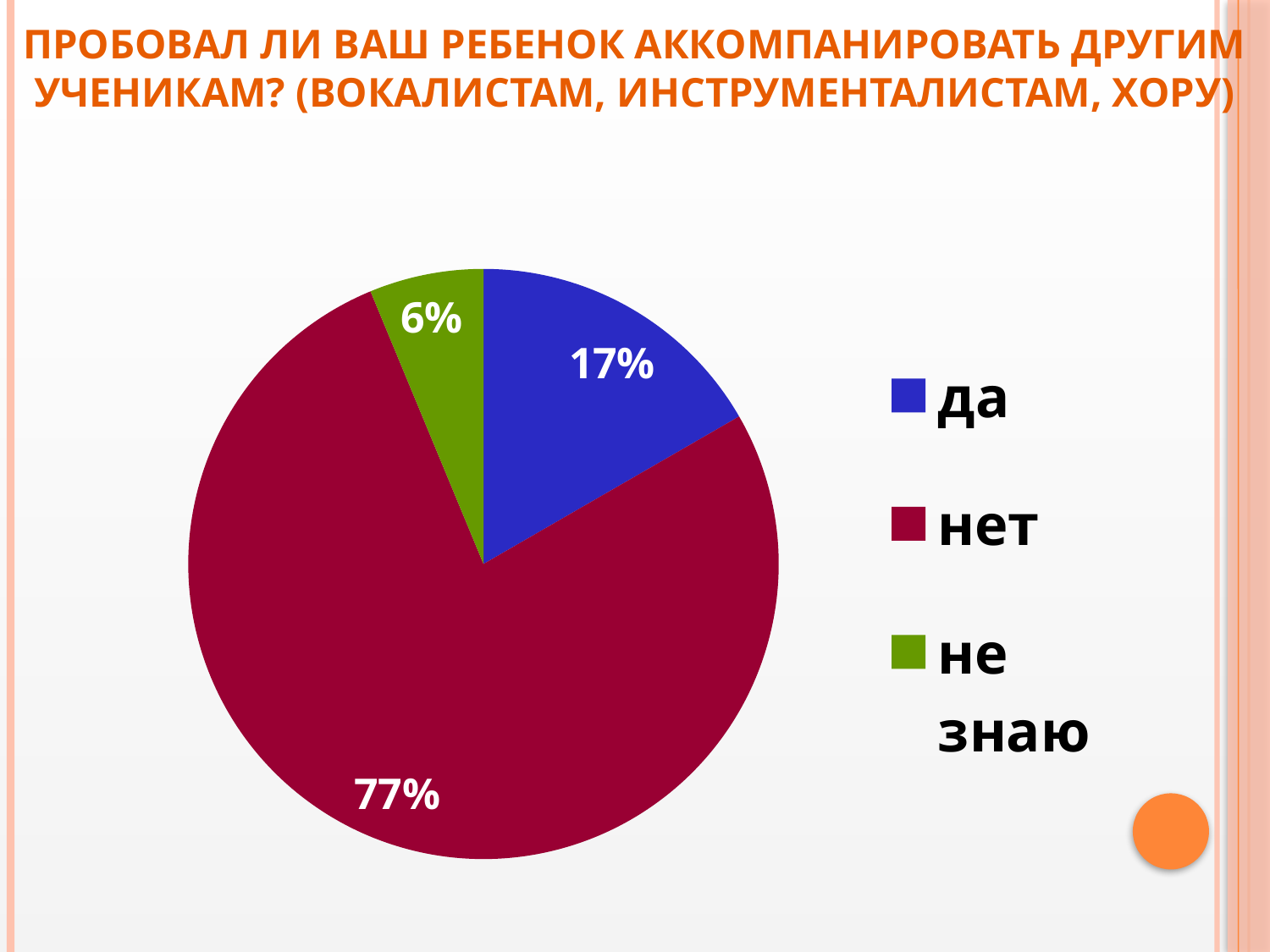
What kind of chart is shown on the slide? pie chart What is the difference in percentage points between the "нет" and "да" slices? 60 What percentage is shown for the "не знаю" slice? 6% Which is larger, the "да" slice or the "не знаю" slice? да Which category has the largest share of the pie? нет What is the difference in percentage points between the "да" and "не знаю" slices? 11 What percentage is shown for the "да" slice? 17% How many entries does the legend list? 3 How many slices does the pie chart have? 3 What percentage is shown for the "нет" slice? 77% Which category has the smallest share of the pie? не знаю What colour is the "нет" slice? dark red